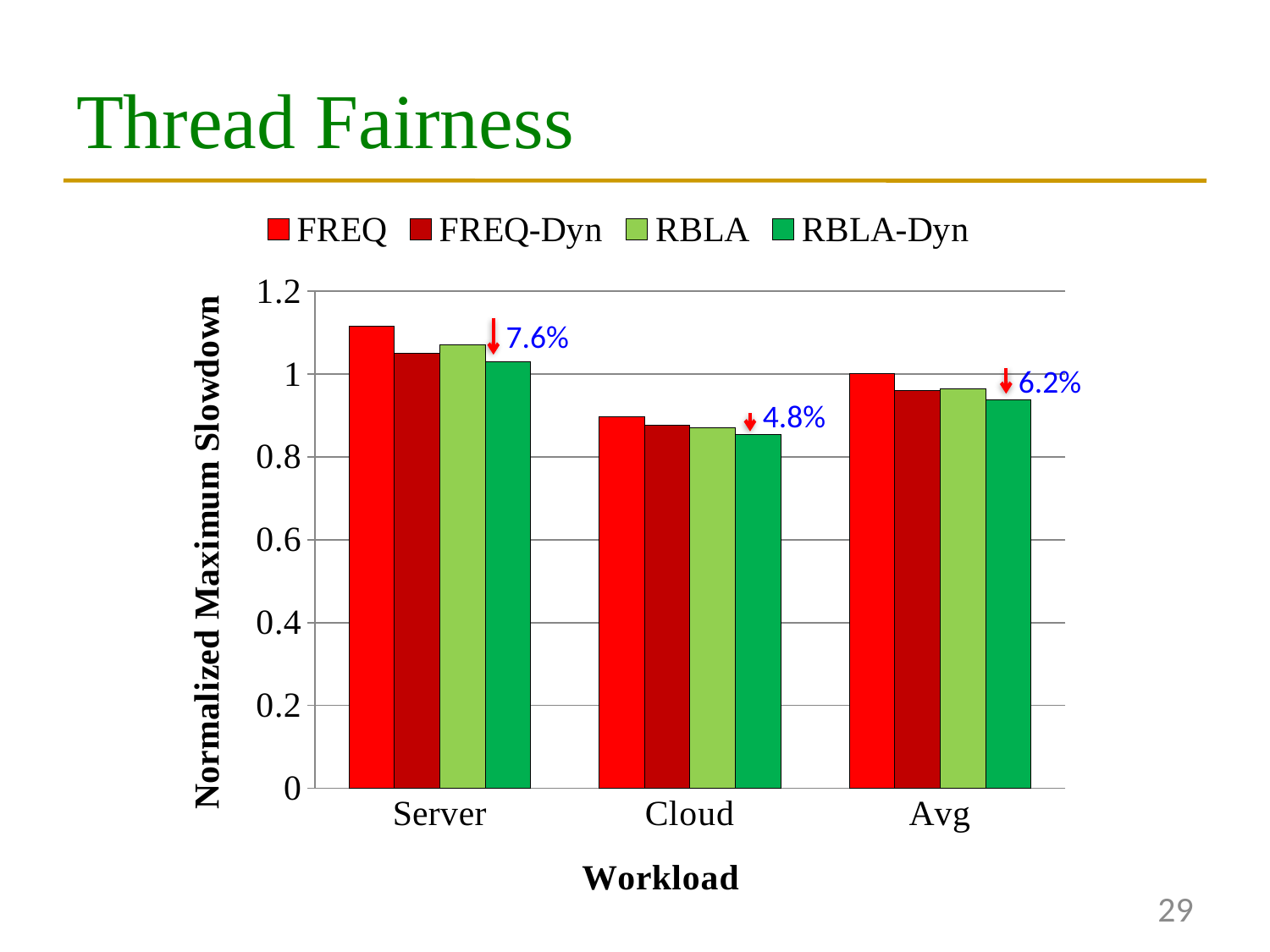
What percentage reduction is annotated above the Server workload bars? 7.6% What kind of chart is shown on the slide? bar chart What is the Normalized Maximum Slowdown for FREQ in the Avg workload? 1 Is the value for RBLA-Dyn in the Cloud workload greater or less than 0.8? greater How many series does the legend list? 4 How many workload categories are shown on the x axis? 3 Is the value for RBLA-Dyn in the Avg workload greater or less than 1? less Which series has the highest value in the Server workload? FREQ Which is larger, the FREQ value for Server or the FREQ value for Cloud? Server Is the value for FREQ in the Cloud workload greater or less than 1? less What is the label of the y axis? Normalized Maximum Slowdown